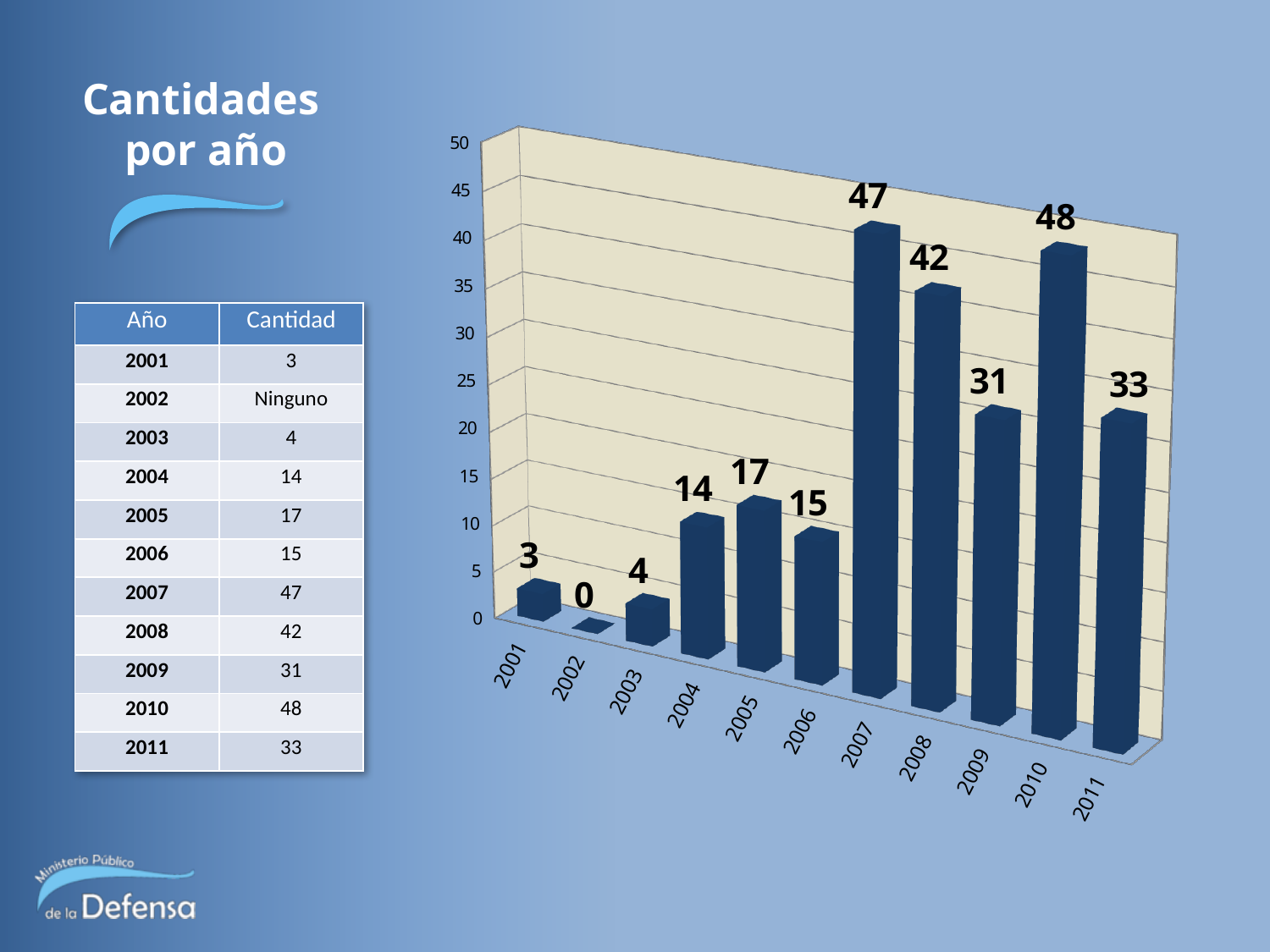
What is the title shown on the slide for the chart? Cantidades por año What kind of chart is shown? bar chart What is the value for 2011? 33 Which year has the lowest value? 2002 What is the value for 2002? 0 Which is larger, the value for 2005 or the value for 2006? 2005 Is the value for 2008 greater or less than 40? greater Which year has the highest value? 2010 How many years are shown on the x axis? 11 What is the difference between the values for 2010 and 2009? 17 What is the value for 2007? 47 Do the values generally rise or fall from 2003 to 2007? rise